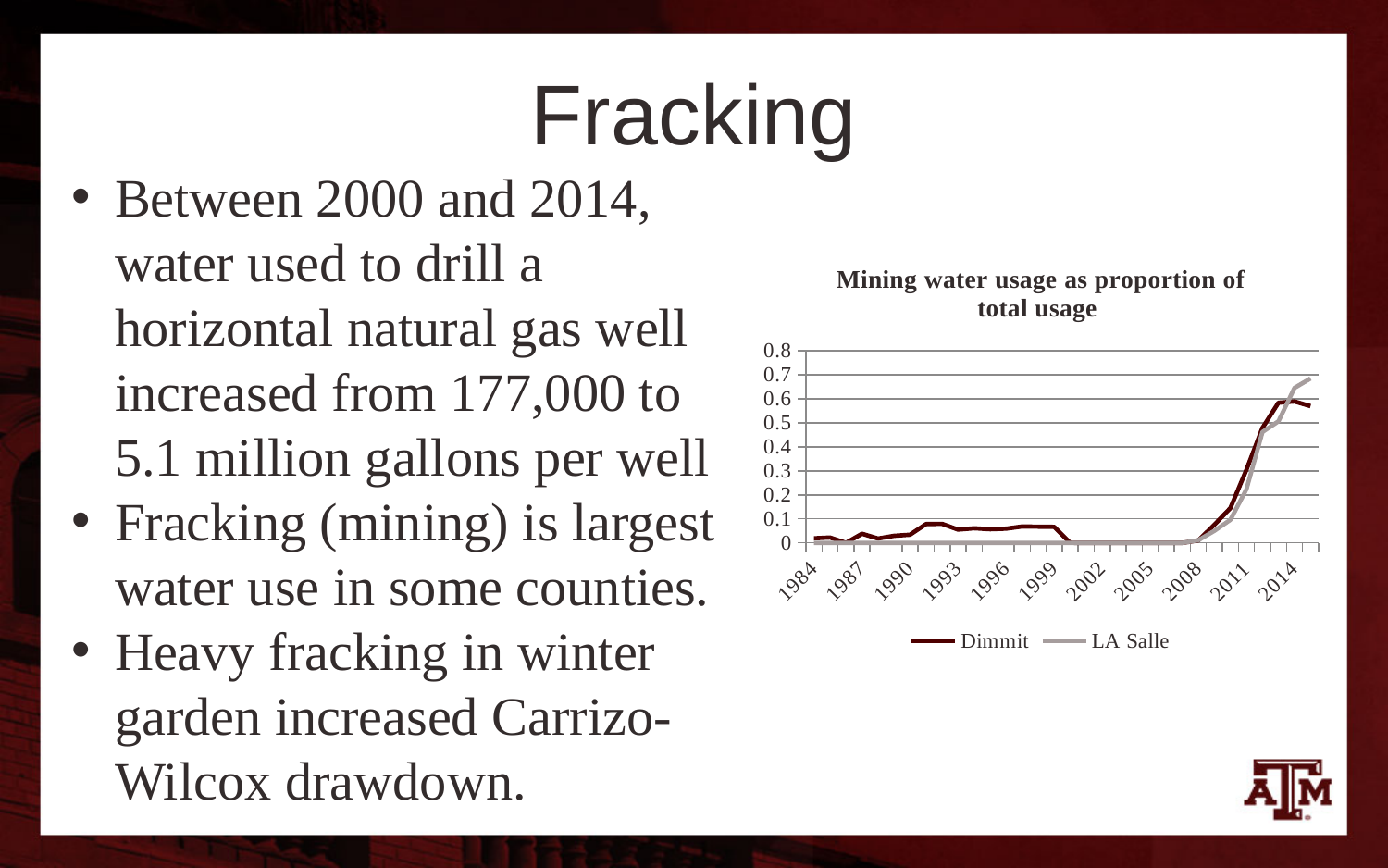
Is the value for Dimmit at the final point of the series greater or less than 0.5? greater How many series does the chart legend list? 2 At the final point of the series, which county has the higher value, Dimmit or LA Salle? LA Salle Is the value for Dimmit in 1993 greater or less than 0.2? less How many year labels are shown on the x axis? 11 In 1996, which county has the higher value, Dimmit or LA Salle? Dimmit Which two counties are shown in the chart legend? Dimmit and LA Salle Is the value for LA Salle at the final point of the series greater or less than 0.6? greater Do the values for both counties rise or fall between 2008 and 2014? rise What kind of chart is shown on the slide? line chart What is the title of the chart? Mining water usage as proportion of total usage